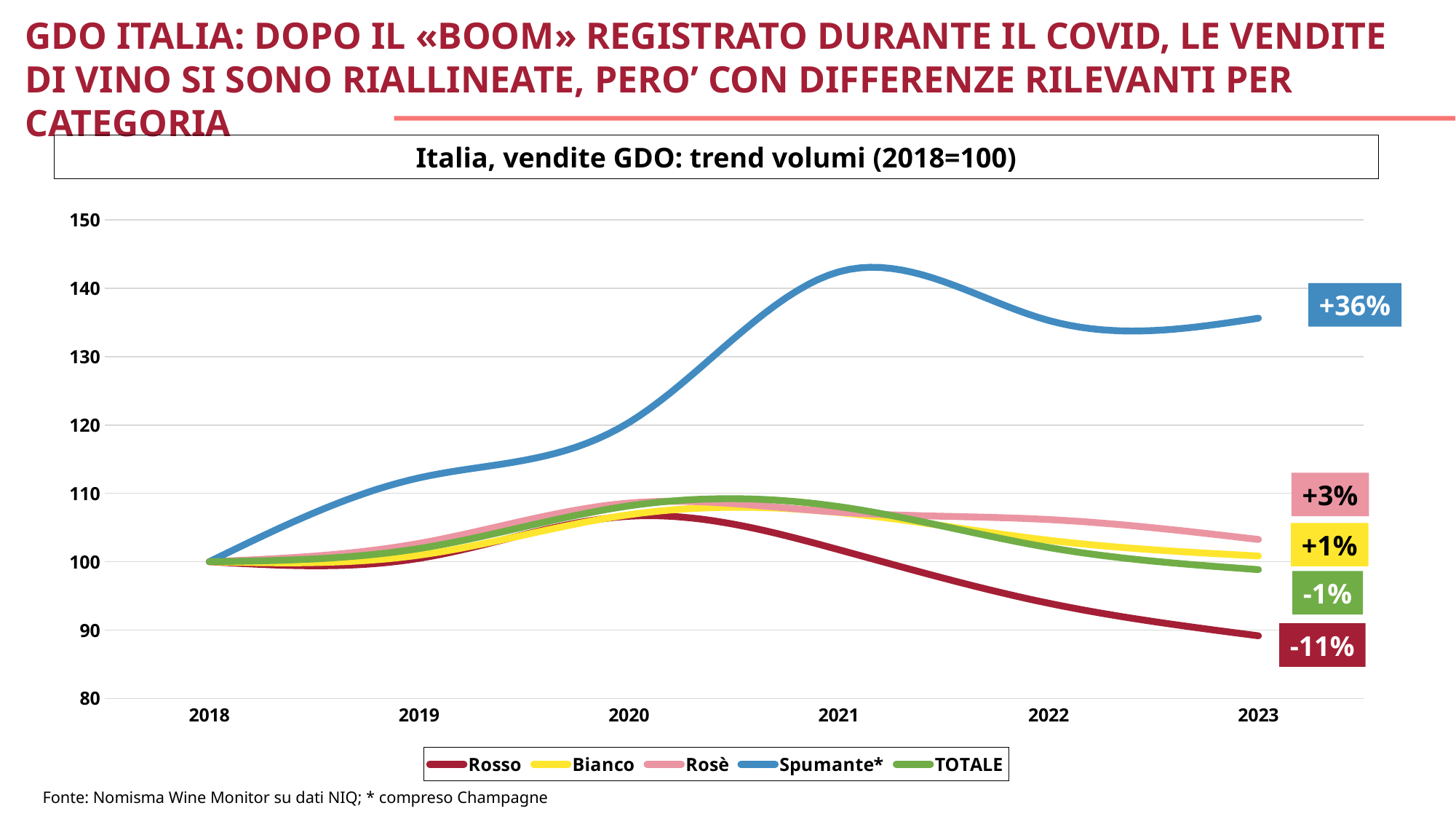
Which series has the highest value in 2023? Spumante* Does the Rosso line rise or fall from 2020 to 2023? fall What is the percentage change label shown for Spumante* at the end of the series? +36% What is the percentage change label shown for Rosso at the end of the series? -11% Is the value for Spumante* in 2021 greater or less than 140? greater Is the value for Rosso in 2022 greater or less than 100? less Which series has the lowest value in 2023? Rosso What kind of chart is shown on the slide? line chart Which has the larger percentage change label, Rosè or Bianco? Rosè How many years are shown on the x axis? 6 What is the percentage change label shown for TOTALE at the end of the series? -1% How many series does the legend list? 5